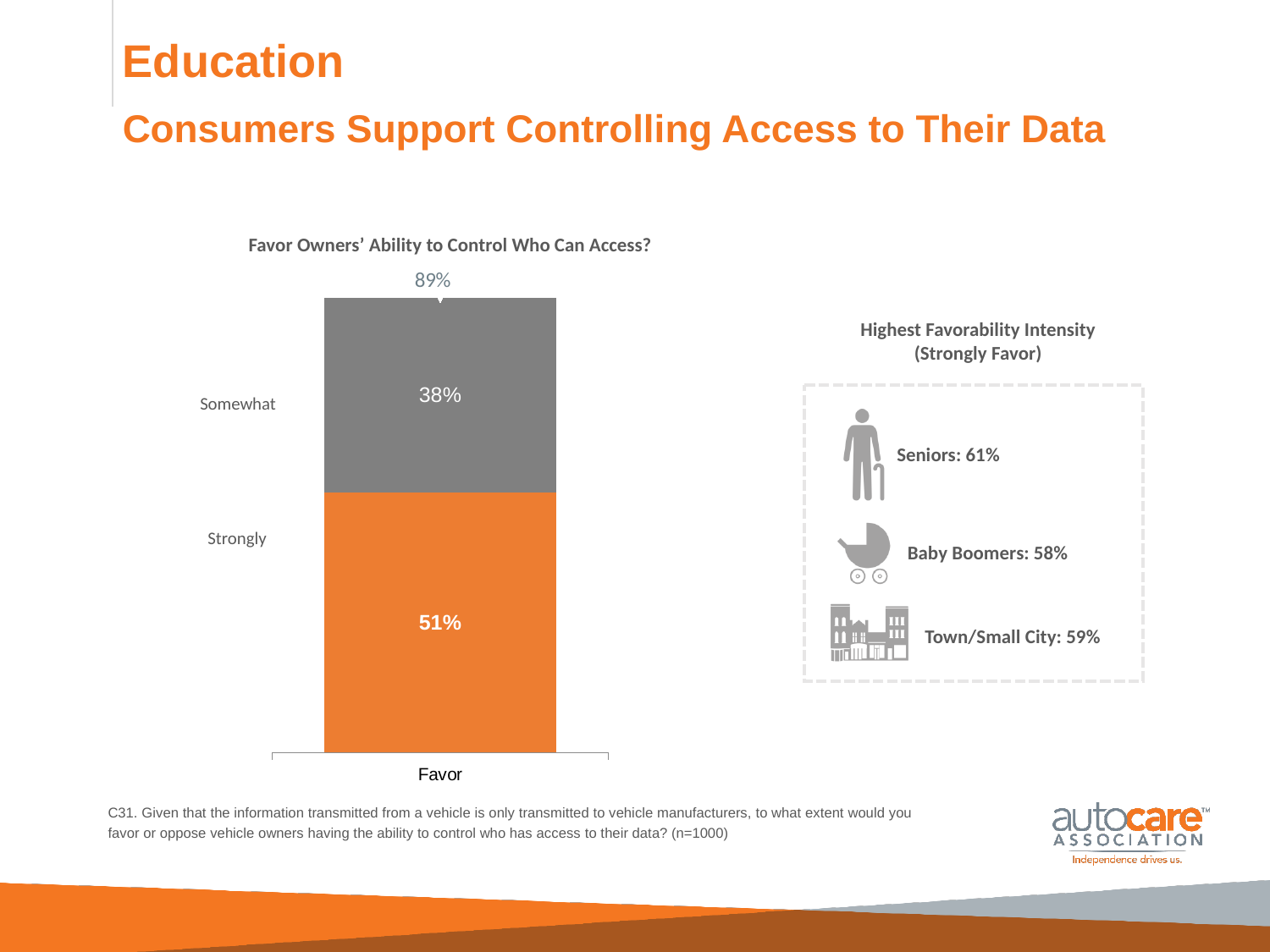
What is the title of the chart? Favor Owners' Ability to Control Who Can Access? How many categories are shown on the x axis of the chart? 1 What colour is the Strongly segment of the Favor bar? Orange What kind of chart is shown on the slide? Stacked bar chart What is the difference between the Strongly and Somewhat segments of the Favor bar? 13% How many segments make up the Favor bar? 2 What percentage of respondents somewhat favor owners' ability to control who can access their data? 38% What is the total percentage shown at the top of the Favor bar? 89% Which segment of the Favor bar is larger, Strongly or Somewhat? Strongly What percentage of respondents strongly favor owners' ability to control who can access their data? 51% Which segment of the Favor bar is the largest? Strongly Which segment of the Favor bar is the smallest? Somewhat